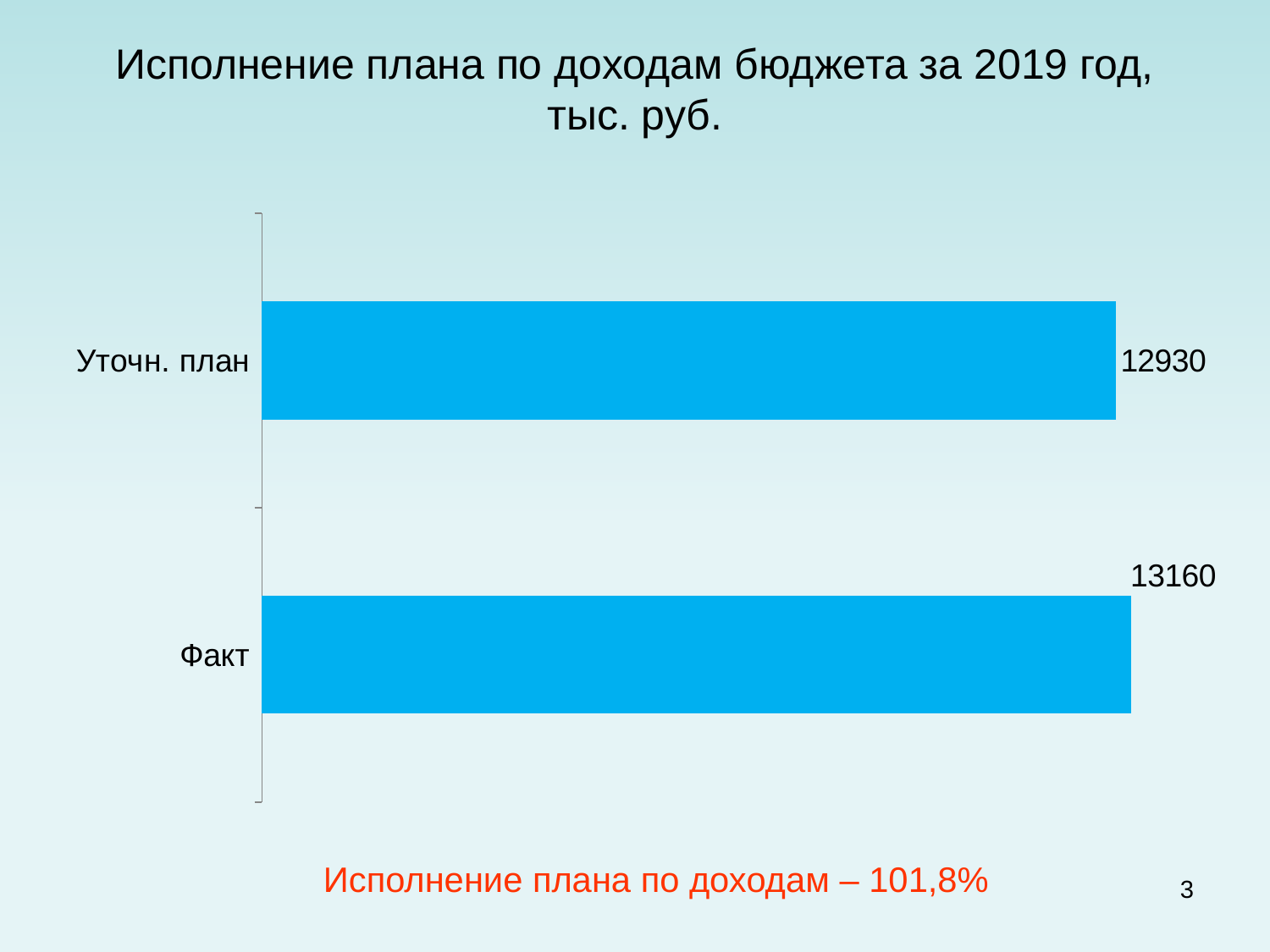
What is the value for Уточн. план? 12930 Which category has the highest value? Факт How many categories are shown in the chart? 2 Which is larger, the value for Факт or the value for Уточн. план? Факт Which category has the lowest value? Уточн. план What percentage of plan execution for revenues is stated below the chart? 101,8% What is the difference between the values for Факт and Уточн. план? 230 What is the title of the chart? Исполнение плана по доходам бюджета за 2019 год, тыс. руб. What kind of chart is shown on the slide? Bar chart What is the value for Факт? 13160